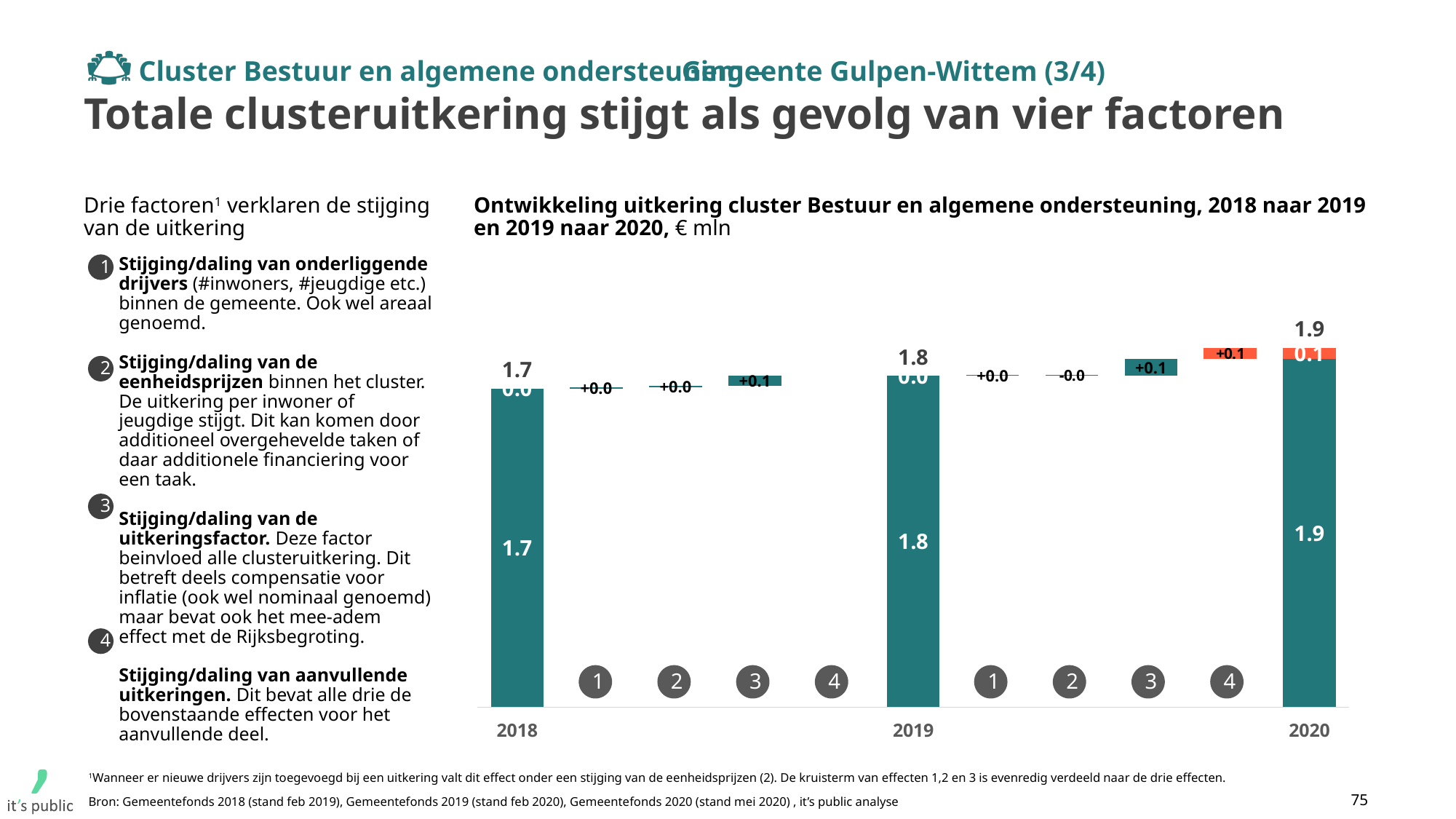
What is the total value shown above the 2019 bar? 1.8 What is the value of the factor 1 step between 2019 and 2020? +0.0 What is the difference between the 2020 total and the 2018 total? 0.2 What is the total value shown above the 2020 bar? 1.9 What is the value of the factor 4 step between 2019 and 2020? +0.1 What is the value of the factor 3 step between 2018 and 2019? +0.1 What is the total value shown above the 2018 bar? 1.7 Do the total values rise or fall from 2018 to 2020? rise In what unit are the values in the chart expressed, according to the chart title? € mln What is the value of the orange (top) segment of the 2020 bar? 0.1 Which year has the lowest total uitkering in the chart? 2018 Which year has the highest total uitkering in the chart? 2020